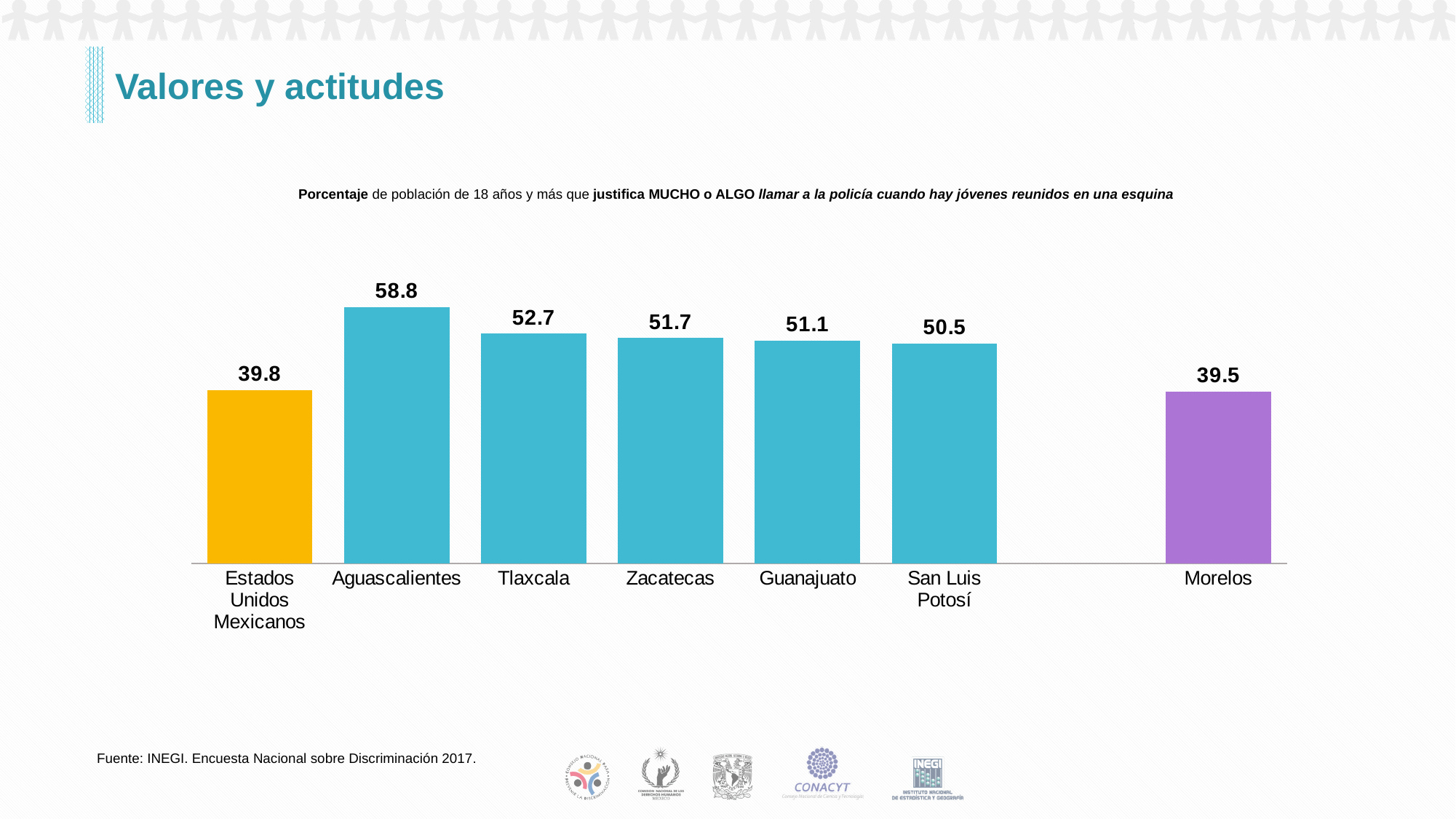
What is the difference between the values for Aguascalientes and Morelos? 19.3 What is the value for Estados Unidos Mexicanos? 39.8 What is the difference between the values for Tlaxcala and Zacatecas? 1.0 Which category has the highest value? Aguascalientes Which category has the lowest value? Morelos What kind of chart is shown on the slide? Bar chart What is the value for San Luis Potosí? 50.5 What colour is the bar for Morelos? Purple What is the value for Morelos? 39.5 What is the value for Aguascalientes? 58.8 How many categories are shown in the chart? 7 Which is larger, the value for Guanajuato or the value for Morelos? Guanajuato